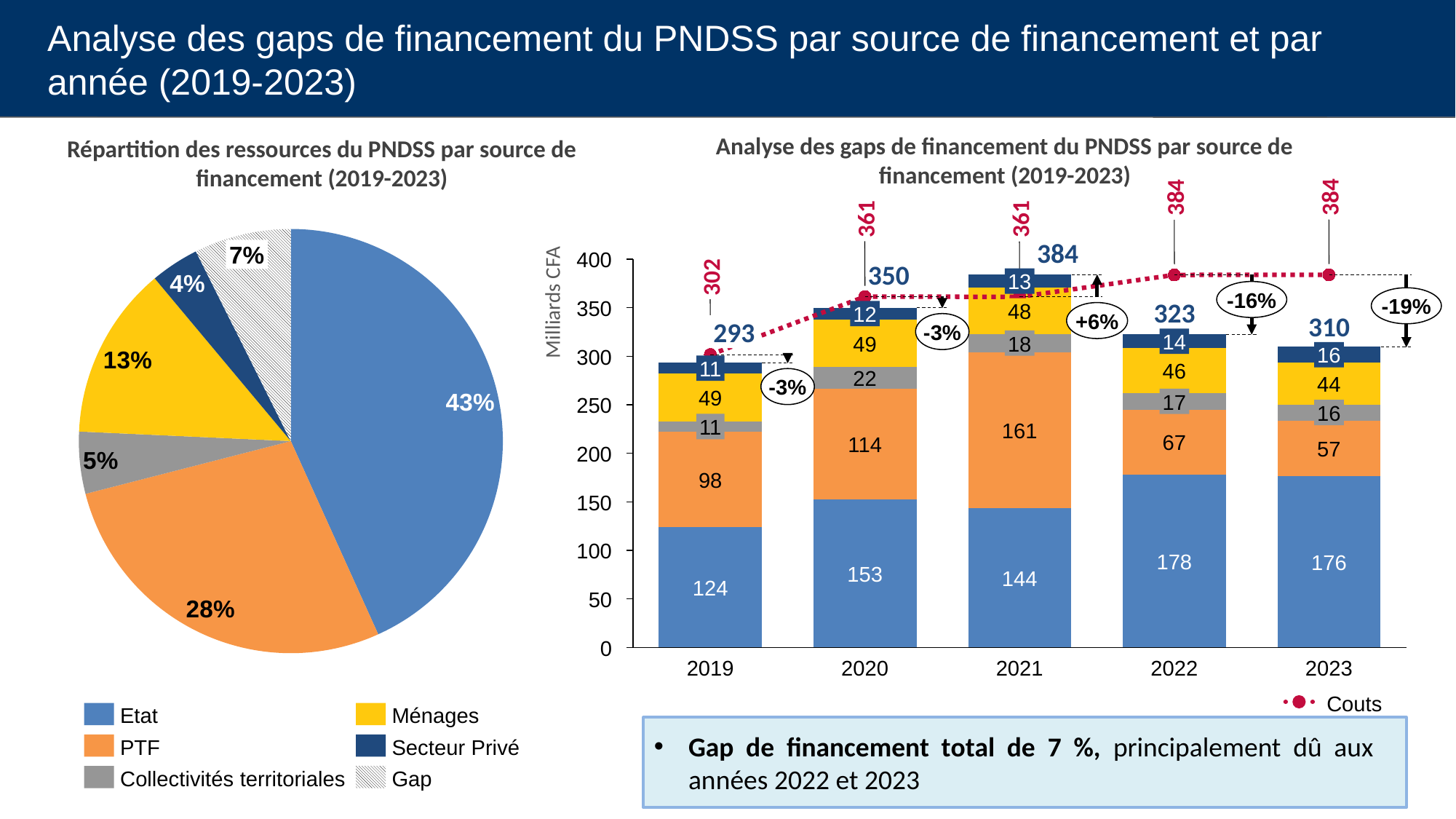
In the pie chart 'Répartition des ressources du PNDSS par source de financement (2019-2023)', how many slices are there? 6 In the bar chart 'Analyse des gaps de financement du PNDSS par source de financement (2019-2023)', what type of chart is it? Stacked bar chart with a line In the bar chart 'Analyse des gaps de financement du PNDSS par source de financement (2019-2023)', which year has the lowest stacked bar total? 2019 In the bar chart 'Analyse des gaps de financement du PNDSS par source de financement (2019-2023)', what is the Etat value for 2022? 178 In the bar chart 'Analyse des gaps de financement du PNDSS par source de financement (2019-2023)', what is the difference between the PTF values for 2021 and 2023? 104 In the bar chart 'Analyse des gaps de financement du PNDSS par source de financement (2019-2023)', what is the unit shown on the vertical axis? Milliards CFA In the pie chart 'Répartition des ressources du PNDSS par source de financement (2019-2023)', what share does Etat represent? 43% In the bar chart 'Analyse des gaps de financement du PNDSS par source de financement (2019-2023)', which is larger: the Etat value for 2020 or the Etat value for 2021? 2020 In the bar chart 'Analyse des gaps de financement du PNDSS par source de financement (2019-2023)', what is the total of the stacked bar for 2021? 384 In the bar chart 'Analyse des gaps de financement du PNDSS par source de financement (2019-2023)', what is the Couts value for 2023? 384 In the pie chart 'Répartition des ressources du PNDSS par source de financement (2019-2023)', what is the share of PTF? 28% In the pie chart 'Répartition des ressources du PNDSS par source de financement (2019-2023)', which source has the smallest share? Secteur Privé